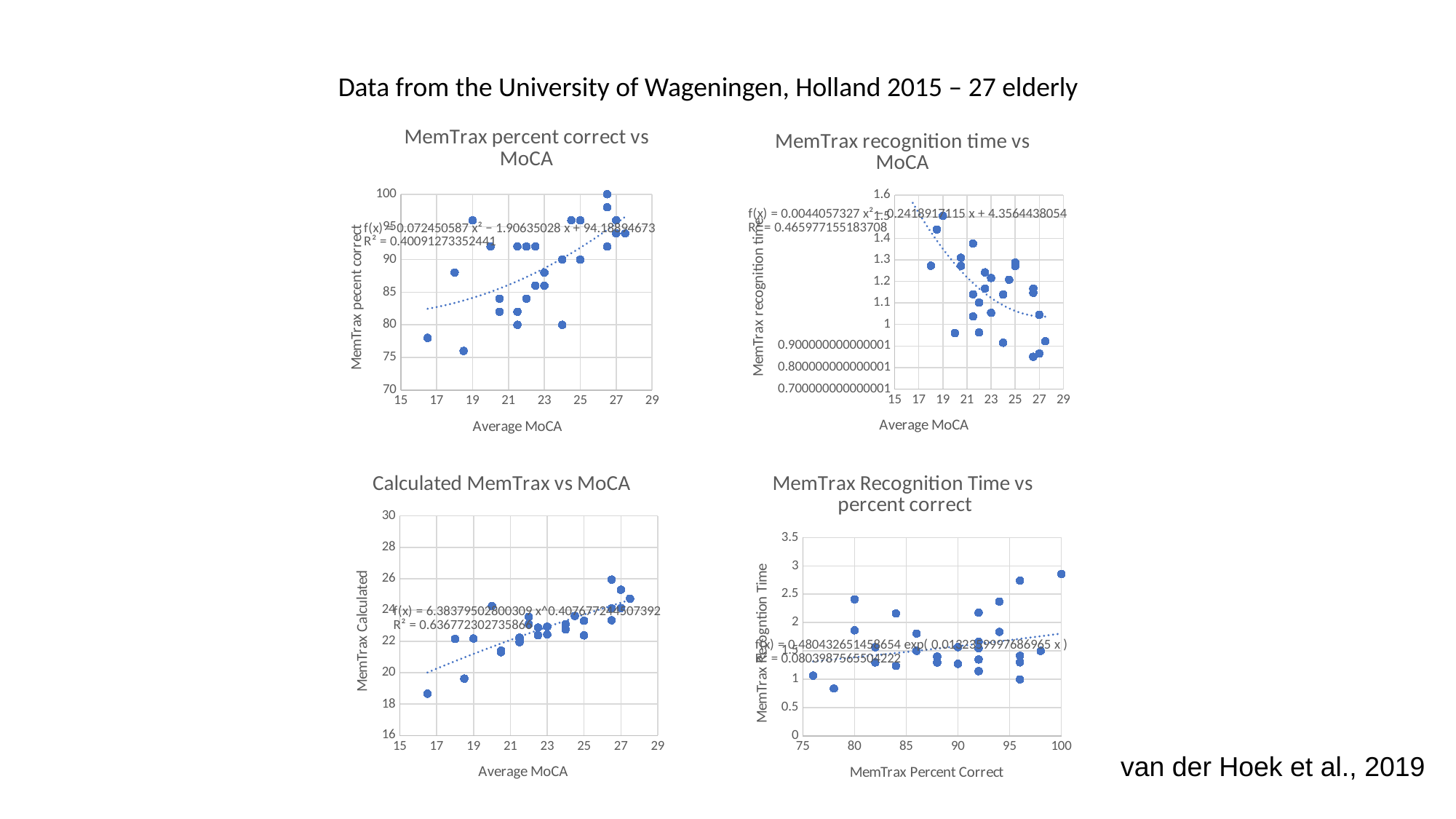
What is the x-axis label of the 'MemTrax Recognition Time vs percent correct' chart? MemTrax Percent Correct What kind of chart is the 'MemTrax percent correct vs MoCA' chart? Scatter chart In the 'MemTrax percent correct vs MoCA' chart, do the values generally rise or fall as Average MoCA increases? Rise In the 'Calculated MemTrax vs MoCA' chart, do the values generally rise or fall as Average MoCA increases? Rise In the 'MemTrax Recognition Time vs percent correct' chart, is the value for the point at 100 percent correct greater or less than 2.5? greater In the 'MemTrax recognition time vs MoCA' chart, do the values generally rise or fall as Average MoCA increases? Fall In the 'MemTrax Recognition Time vs percent correct' chart, is the value for the point at 78 percent correct greater or less than 1? less What is the y-axis label of the 'Calculated MemTrax vs MoCA' chart? MemTrax Calculated How many charts are shown on the slide? 4 In the 'MemTrax percent correct vs MoCA' chart, is the value for the leftmost point (Average MoCA about 16.5) greater or less than 80? less